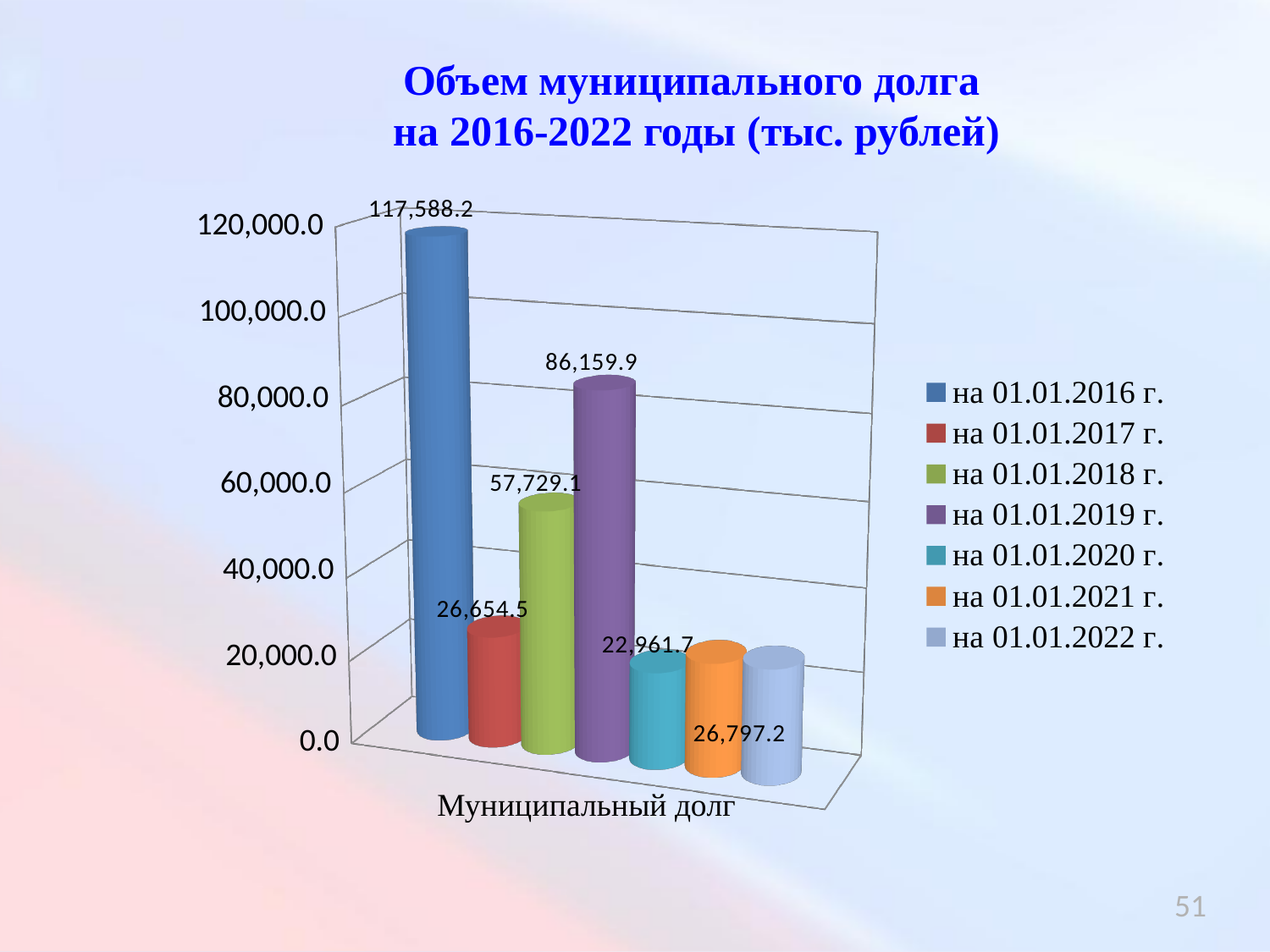
What is the difference between the values for на 01.01.2016 г. and на 01.01.2019 г.? 31,428.3 What is the title of the chart? Объем муниципального долга на 2016-2022 годы (тыс. рублей) How many series does the legend list? 7 What is the value for на 01.01.2017 г.? 26,654.5 Is the value for на 01.01.2016 г. greater or less than 100,000.0? greater What is the value for на 01.01.2019 г.? 86,159.9 Which series has the highest value? на 01.01.2016 г. What is the value for на 01.01.2018 г.? 57,729.1 What kind of chart is shown on the slide? bar chart Which is larger, the value for на 01.01.2018 г. or на 01.01.2017 г.? на 01.01.2018 г. What is the value for на 01.01.2016 г.? 117,588.2 What is the value for на 01.01.2020 г.? 22,961.7